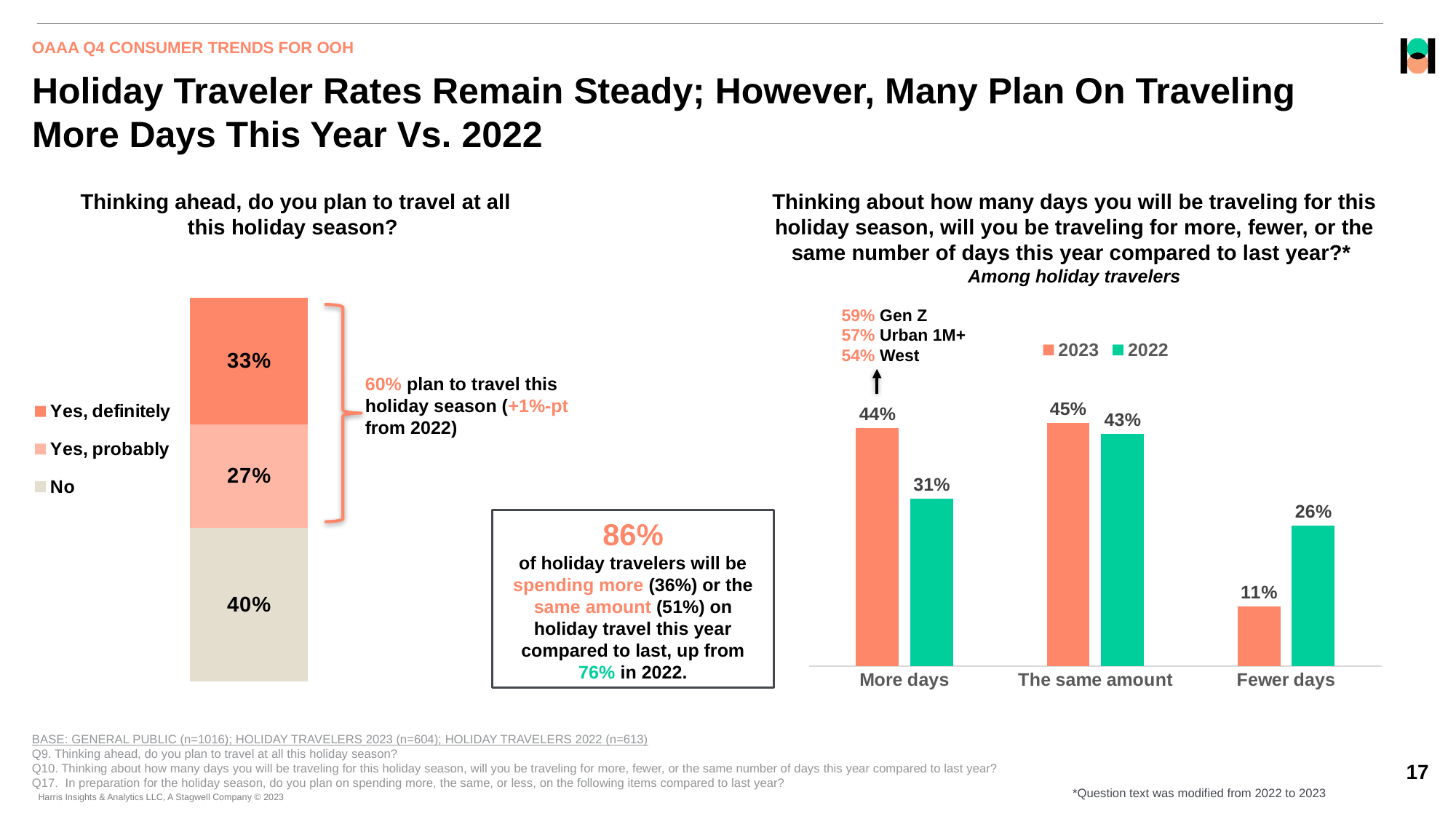
In the right chart (number of travel days compared to last year), how many series does the legend list? 2 In the right chart (number of travel days compared to last year), what is the 2023 value for "More days"? 44% In the right chart (number of travel days compared to last year), what is the difference between the 2023 and 2022 values for "More days"? 13 percentage points In the left chart ("Thinking ahead, do you plan to travel at all this holiday season?"), how many response categories does the legend list? 3 In the left chart ("Thinking ahead, do you plan to travel at all this holiday season?"), what is the combined total of "Yes, definitely" and "Yes, probably"? 60% In the right chart (number of travel days compared to last year), what is the 2022 value for "Fewer days"? 26% In the left chart ("Thinking ahead, do you plan to travel at all this holiday season?"), what percentage answered "Yes, definitely"? 33% In the right chart (number of travel days compared to last year), which category has the highest 2022 value? The same amount In the right chart (number of travel days compared to last year), which category has the lowest 2023 value? Fewer days In the left chart ("Thinking ahead, do you plan to travel at all this holiday season?"), what percentage answered "No"? 40% In the right chart (number of travel days compared to last year), is the 2023 value for "Fewer days" larger or smaller than the 2022 value? smaller What type of chart is the right chart (number of travel days compared to last year)? bar chart